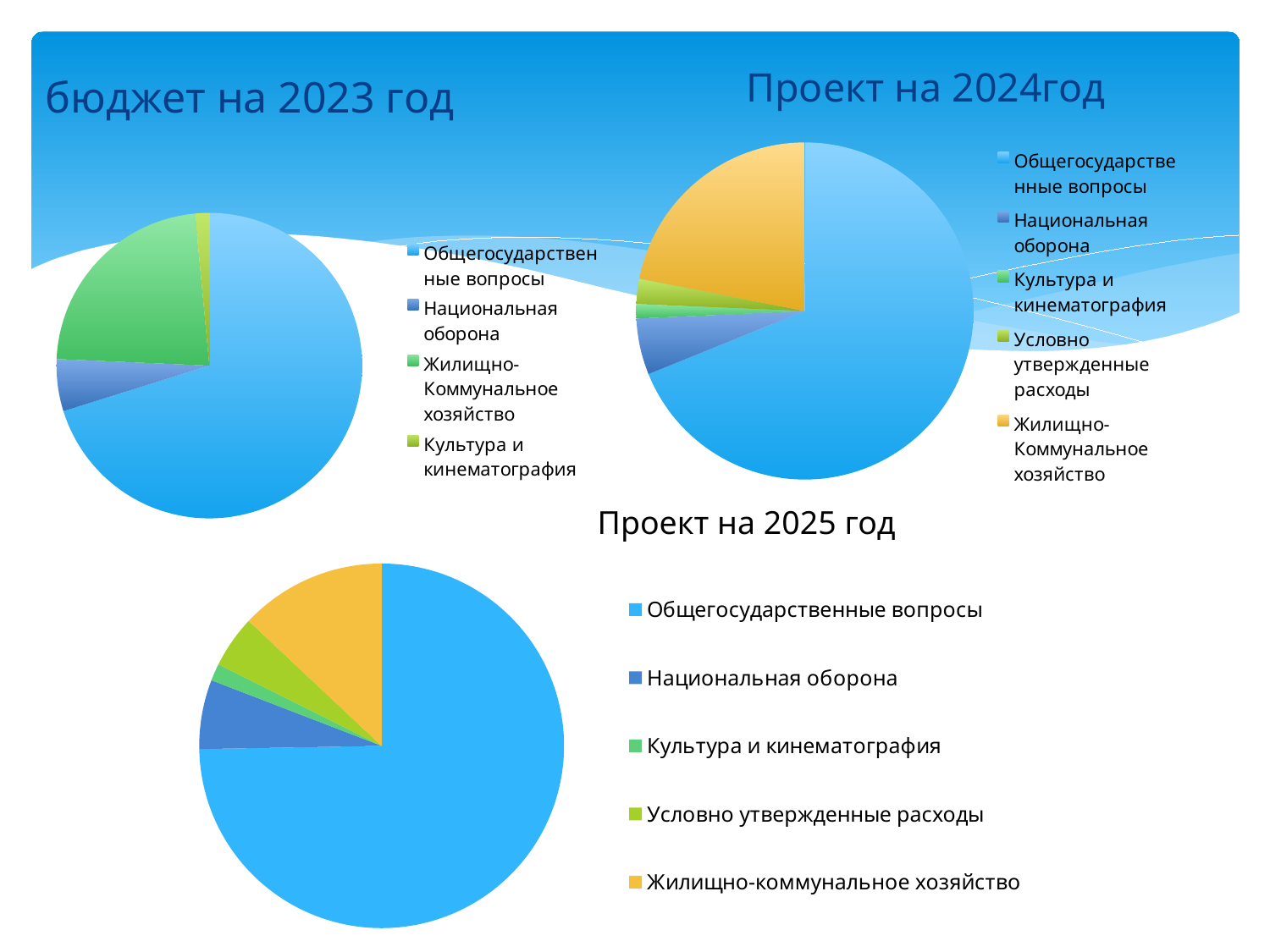
In the "бюджет на 2023 год" chart, which slice is larger: Жилищно-Коммунальное хозяйство or Национальная оборона? Жилищно-Коммунальное хозяйство In the "бюджет на 2023 год" chart, which category has the largest slice? Общегосударственные вопросы How many pie charts are shown on the slide? 3 In the "Проект на 2024год" chart, which category has the largest slice? Общегосударственные вопросы What is the title of the chart at the bottom of the slide? Проект на 2025 год In the "Проект на 2025 год" chart, which category has the smallest slice? Культура и кинематография In the "бюджет на 2023 год" chart, how many categories does the legend list? 4 In the "Проект на 2025 год" chart, which slice is larger: Условно утвержденные расходы or Культура и кинематография? Условно утвержденные расходы In the "бюджет на 2023 год" chart, which category has the smallest slice? Культура и кинематография In the "Проект на 2025 год" chart, how many categories does the legend list? 5 What kind of chart is used for "бюджет на 2023 год"? pie chart